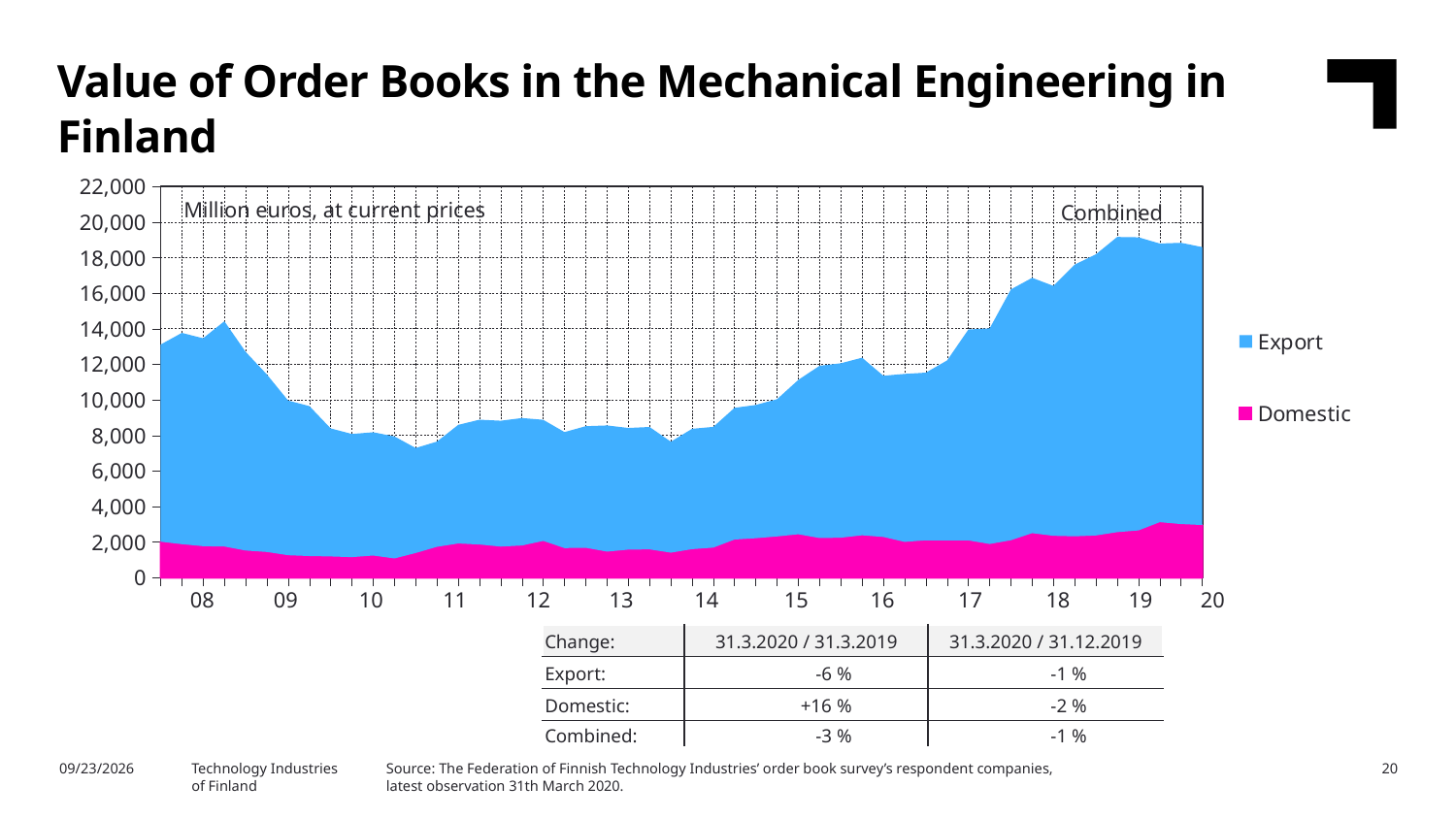
What are the two series named in the chart's legend? Export and Domestic How many series does the chart's legend list? 2 What unit label is printed inside the chart area? Million euros, at current prices Which is larger, the combined value of order books in 2019 or in 2010? 2019 Does the combined value of order books rise or fall between 2008 and 2010? fall What kind of chart is shown on the slide? Stacked area chart Is the combined value of order books around 2010 greater or less than 10,000? less Which series is larger in 2015, Export or Domestic? Export Is the combined value of order books in 2013 greater or less than 10,000? less Does the combined value of order books rise or fall between 2014 and 2019? rise Is the combined value of order books at the peak in 2019 greater or less than 18,000? greater